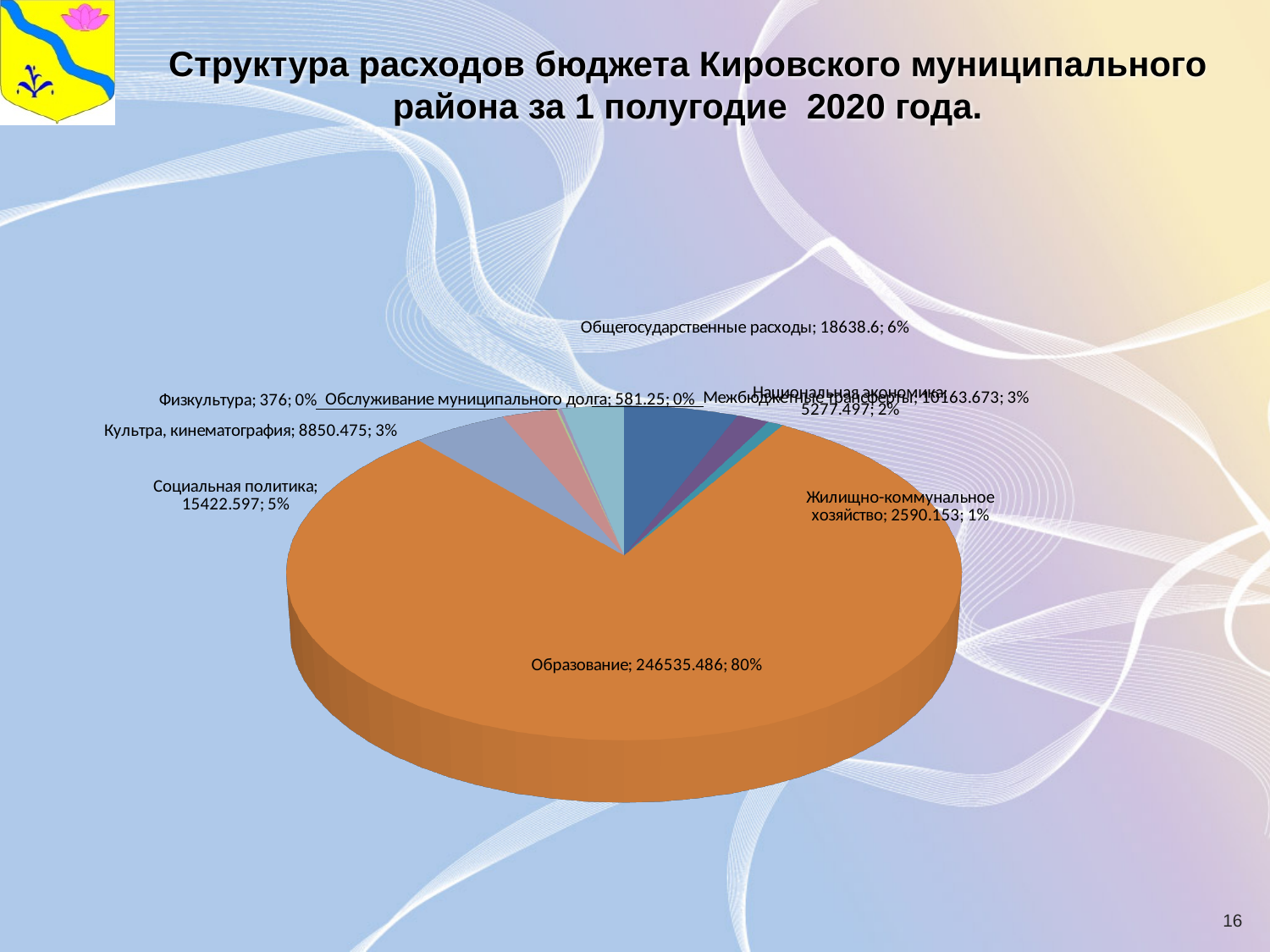
Which is larger: Социальная политика or Культра, кинематография? Социальная политика Which category has the largest slice of the pie? Образование What share of the pie does Образование take? 80% What value is shown for Образование? 246535.486 What kind of chart is shown on the slide? pie chart What value is shown for Жилищно-коммунальное хозяйство? 2590.153 Which category has the smallest value in the pie? Физкультура What value is shown for Социальная политика? 15422.597 How many categories are shown in the pie chart? 9 What is the difference between the values for Общегосударственные расходы and Социальная политика? 3216.003 What value is shown for Физкультура? 376 What share of the pie does Общегосударственные расходы take? 6%